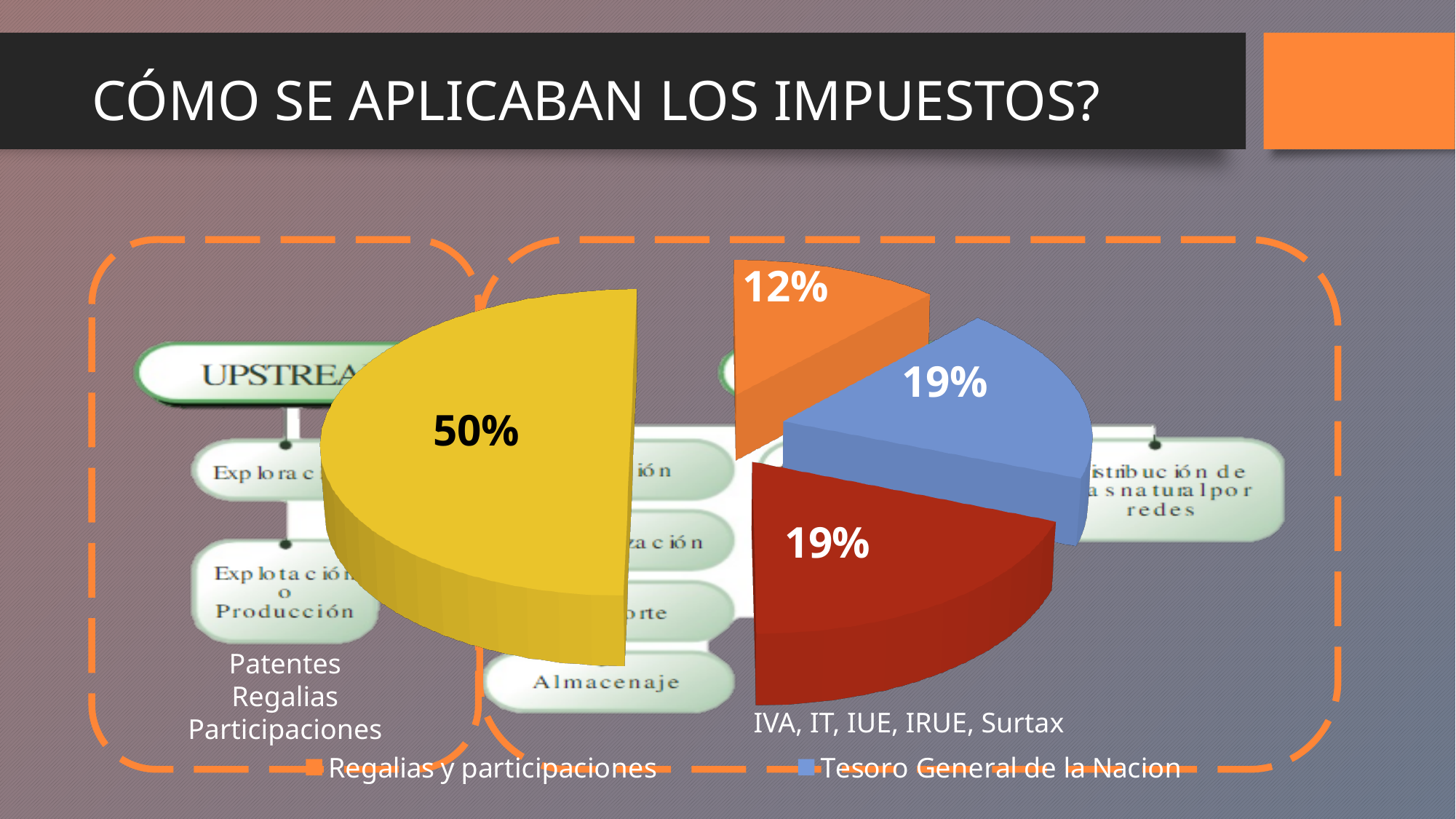
What is the value of the largest slice in the pie chart? 50% What is the value of the smallest slice in the pie chart? 12% What colour is the legend marker for 'Tesoro General de la Nacion'? blue What is the difference between the yellow slice (50%) and the orange slice (12%)? 38 percentage points What percentage is shown on the blue slice of the pie chart? 19% How many slices does the pie chart have? 4 What kind of chart is shown on the slide? pie chart How many entries are visible in the pie chart's legend? 2 What percentage is shown on the orange slice of the pie chart? 12% Which slice is larger, the yellow slice or the red slice? the yellow slice What share of the pie does 'Regalias y participaciones' represent? 12% What share of the pie does 'Tesoro General de la Nacion' represent? 19%